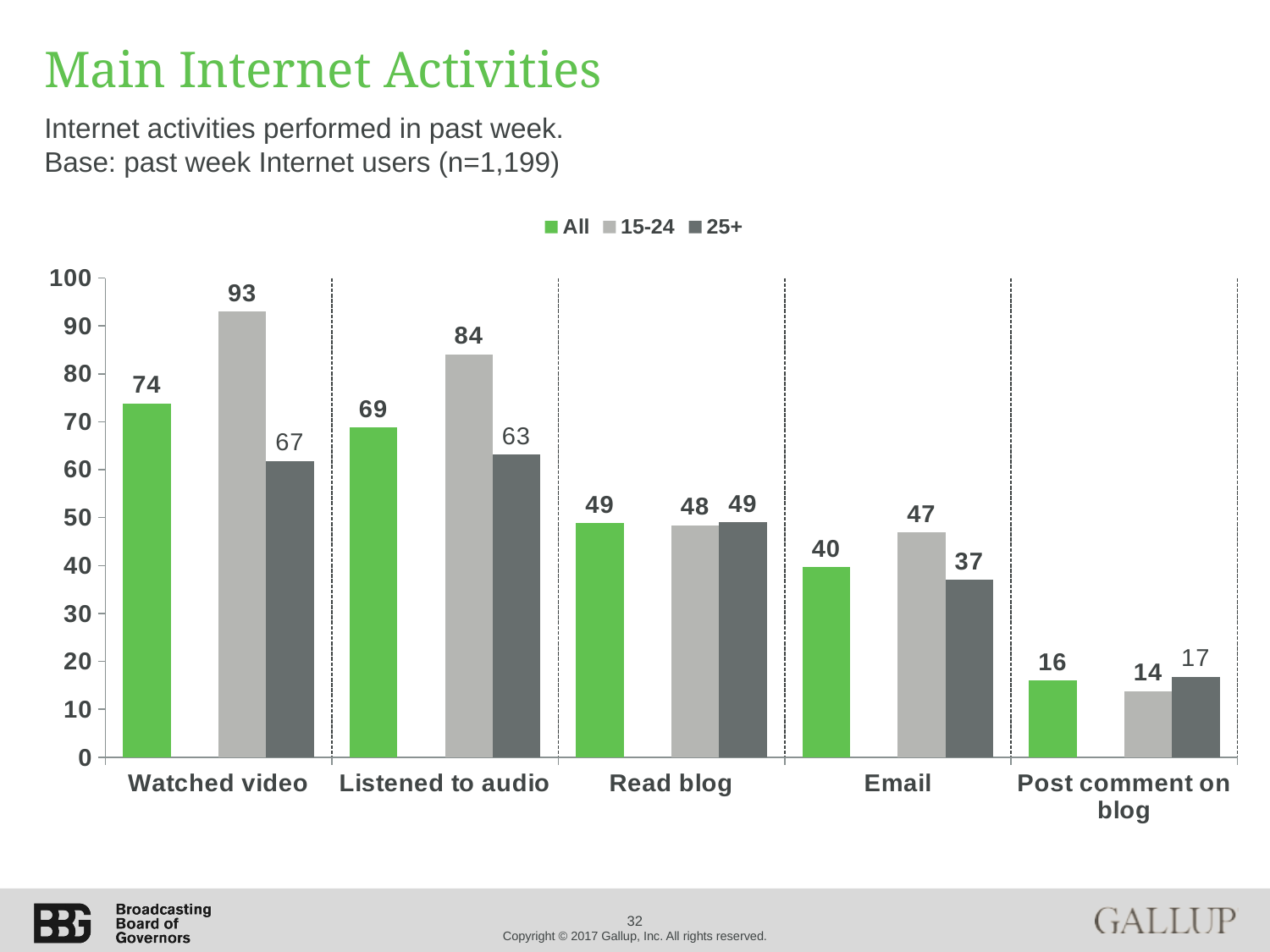
What is the value for the 15-24 series for Watched video? 93 What is the difference between the 15-24 and 25+ values for Watched video? 26 How many activity categories are shown on the x axis? 5 Which is larger for Email: the 15-24 value or the 25+ value? 15-24 What is the title of the slide? Main Internet Activities What is the value for the All series for Email? 40 How many series does the legend list? 3 Is the value for the All series for Listened to audio greater or less than 60? greater What is the value for the 25+ series for Listened to audio? 63 Which activity has the lowest value for the 15-24 series? Post comment on blog Which activity has the highest value for the All series? Watched video What kind of chart is shown on the slide? bar chart